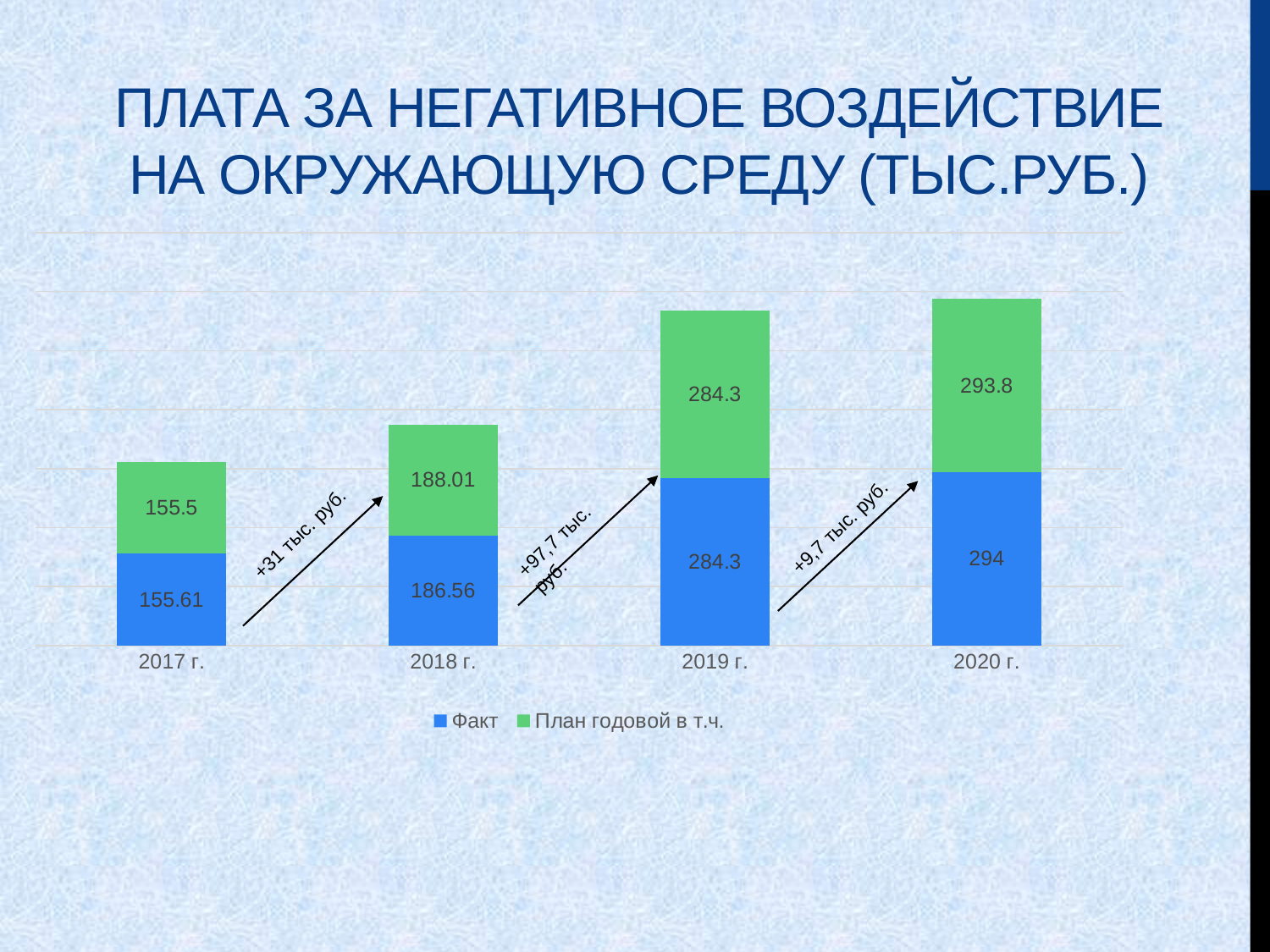
What is the План годовой в т.ч. value for 2020 г.? 293.8 What is the Факт value for 2019 г.? 284.3 How many years are shown on the x axis? 4 What kind of chart is shown on the slide? Stacked bar chart What is the difference between the Факт values for 2018 г. and 2017 г.? 30.95 Which year has the highest Факт value? 2020 г. Which is larger: the Факт value for 2019 г. or the Факт value for 2018 г.? 2019 г. How many series does the legend list? 2 What is the Факт value for 2017 г.? 155.61 Which year has the lowest План годовой в т.ч. value? 2017 г. What is the План годовой в т.ч. value for 2018 г.? 188.01 Do the Факт values rise or fall from 2017 г. to 2020 г.? Rise